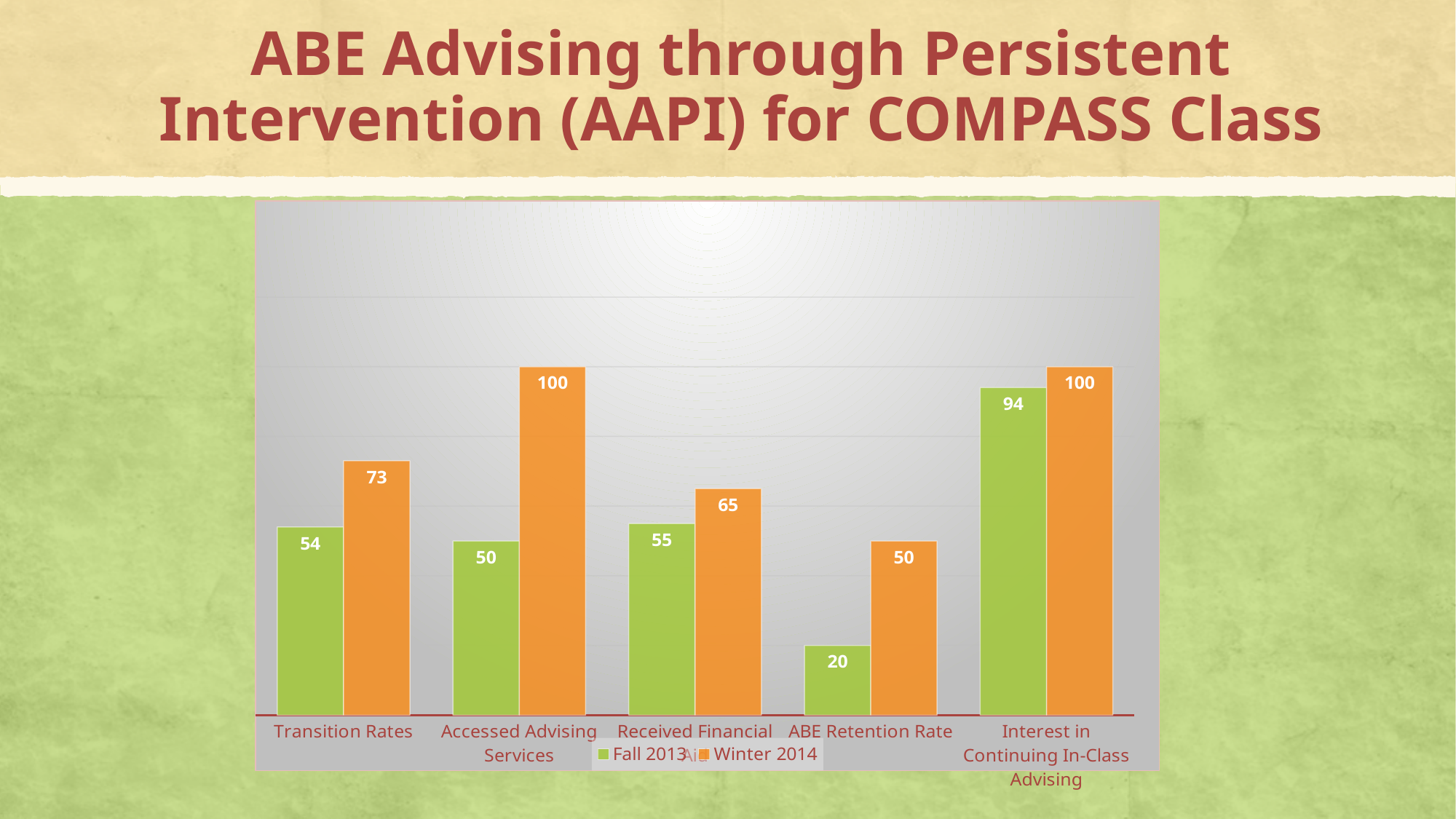
What is the difference between the Winter 2014 and Fall 2013 values for Transition Rates? 19 Which category has the highest Fall 2013 value? Interest in Continuing In-Class Advising Which category has the lowest Fall 2013 value? ABE Retention Rate What is the difference between the Winter 2014 and Fall 2013 values for Accessed Advising Services? 50 What kind of chart is shown on the slide? Bar chart How many series does the legend list? 2 What is the Fall 2013 value for Transition Rates? 54 How many categories are shown on the x axis? 5 What is the Fall 2013 value for ABE Retention Rate? 20 What is the Winter 2014 value for Accessed Advising Services? 100 What is the Winter 2014 value for Received Financial Aid? 65 Which is larger for ABE Retention Rate: the Fall 2013 value or the Winter 2014 value? Winter 2014